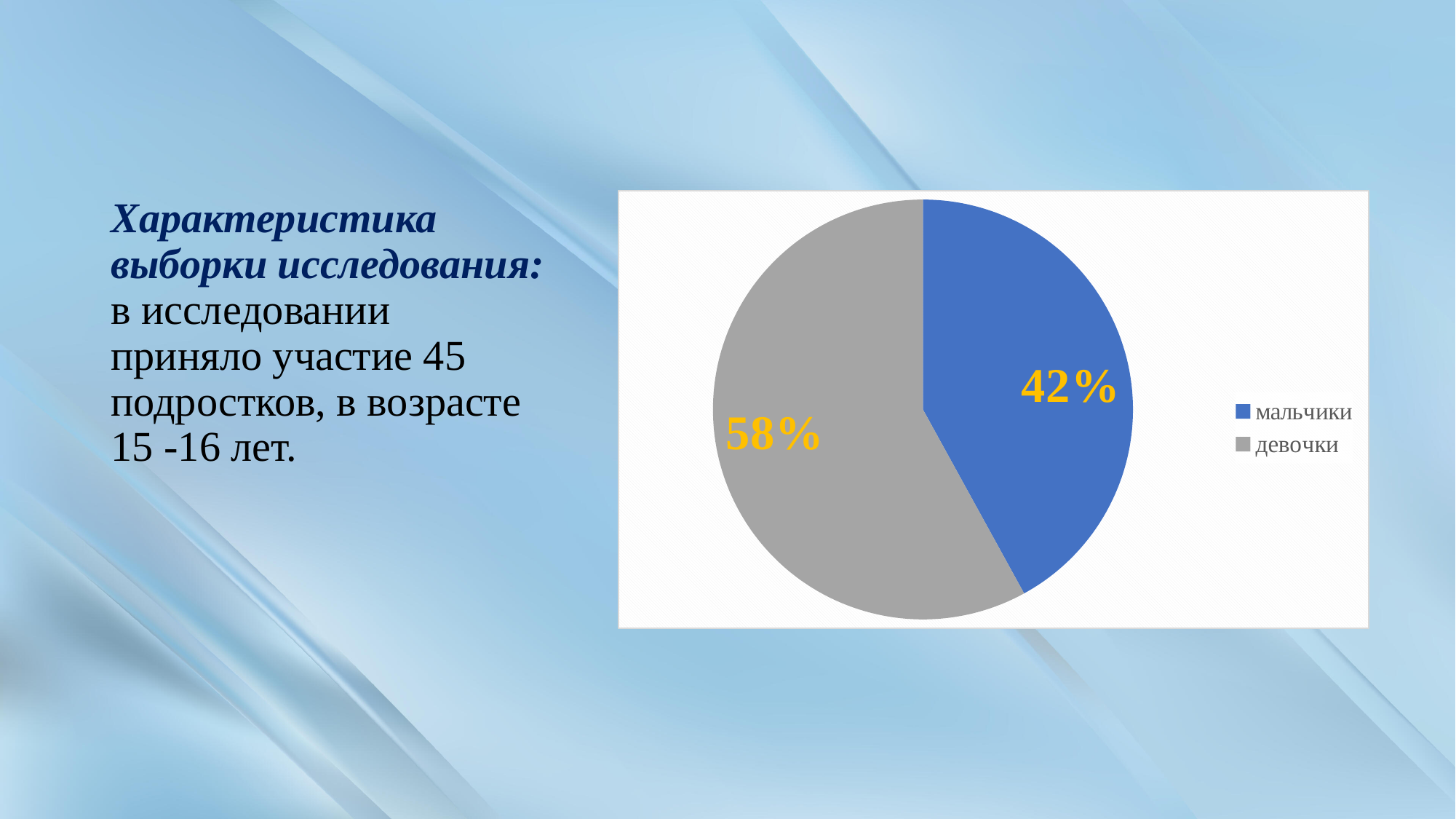
Is the share for девочки greater or less than 50%? greater Which slice is larger, мальчики or девочки? девочки Which category has the largest slice of the pie? девочки What share of the pie is labelled for девочки? 58% How many entries does the legend list? 2 What is the difference in percentage points between the девочки slice and the мальчики slice? 16% What kind of chart is shown on the slide? pie chart How many slices does the pie chart have? 2 What colour is the slice for девочки? grey What colour is the slice for мальчики? blue Which category has the smallest slice of the pie? мальчики What share of the pie is labelled for мальчики? 42%